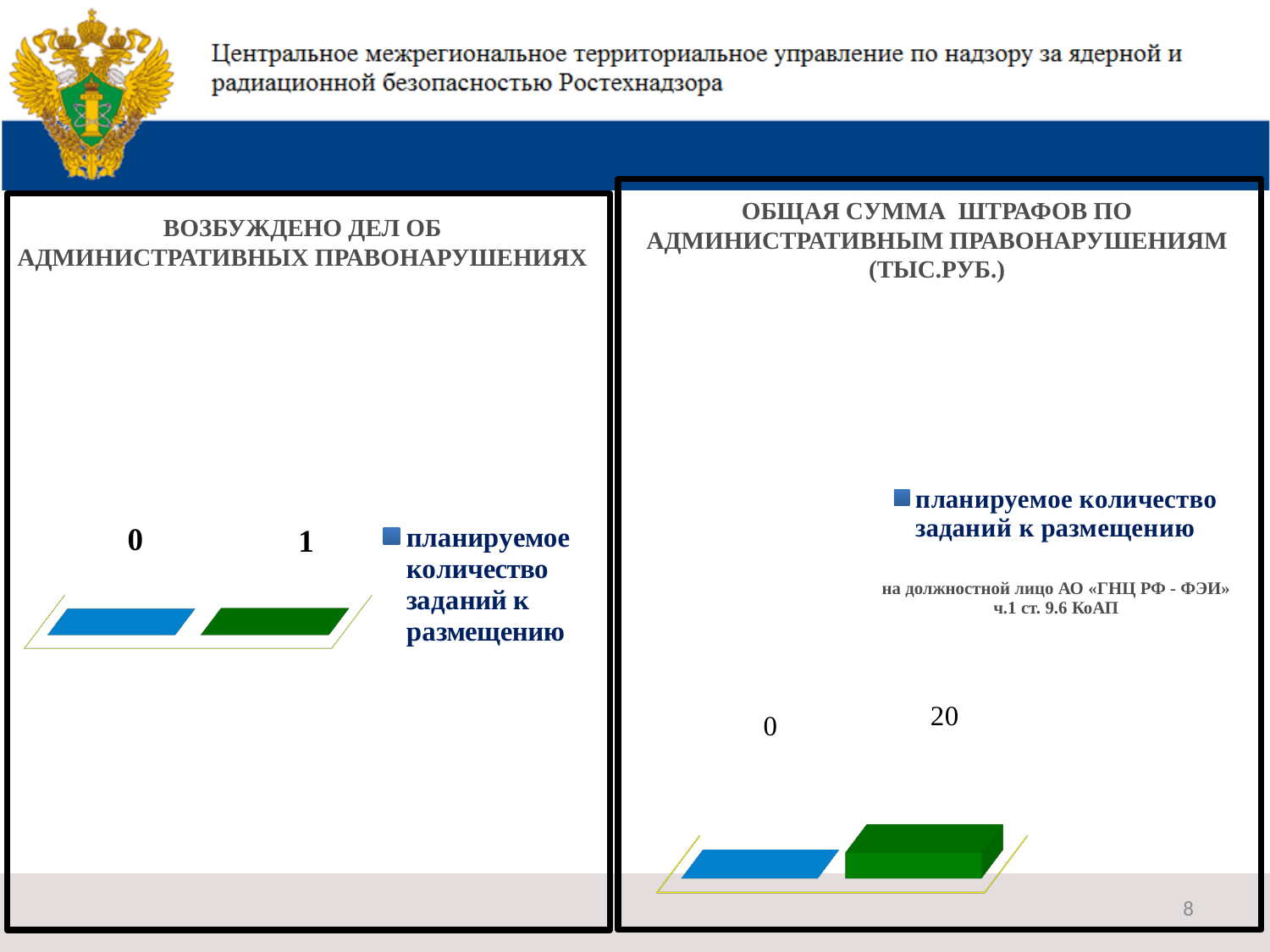
In the right chart titled «ОБЩАЯ СУММА ШТРАФОВ ПО АДМИНИСТРАТИВНЫМ ПРАВОНАРУШЕНИЯМ (ТЫС.РУБ.)», what is the difference between the two labelled values? 20 In the right chart titled «ОБЩАЯ СУММА ШТРАФОВ ПО АДМИНИСТРАТИВНЫМ ПРАВОНАРУШЕНИЯМ (ТЫС.РУБ.)», how many series does the legend list? 1 In the right chart titled «ОБЩАЯ СУММА ШТРАФОВ ПО АДМИНИСТРАТИВНЫМ ПРАВОНАРУШЕНИЯМ (ТЫС.РУБ.)», what value is labelled above the green bar? 20 What legend entry is shown for the left chart titled «ВОЗБУЖДЕНО ДЕЛ ОБ АДМИНИСТРАТИВНЫХ ПРАВОНАРУШЕНИЯХ»? планируемое количество заданий к размещению In the left chart titled «ВОЗБУЖДЕНО ДЕЛ ОБ АДМИНИСТРАТИВНЫХ ПРАВОНАРУШЕНИЯХ», what is the lowest data label shown? 0 In the left chart titled «ВОЗБУЖДЕНО ДЕЛ ОБ АДМИНИСТРАТИВНЫХ ПРАВОНАРУШЕНИЯХ», what value is labelled above the green bar? 1 In the right chart titled «ОБЩАЯ СУММА ШТРАФОВ ПО АДМИНИСТРАТИВНЫМ ПРАВОНАРУШЕНИЯМ (ТЫС.РУБ.)», what value is labelled above the blue bar? 0 What unit is given in the title of the right chart? ТЫС.РУБ. What kind of chart is the left chart titled «ВОЗБУЖДЕНО ДЕЛ ОБ АДМИНИСТРАТИВНЫХ ПРАВОНАРУШЕНИЯХ»? bar chart In the right chart titled «ОБЩАЯ СУММА ШТРАФОВ ПО АДМИНИСТРАТИВНЫМ ПРАВОНАРУШЕНИЯМ (ТЫС.РУБ.)», which bar is taller, the blue one or the green one? the green one In the left chart titled «ВОЗБУЖДЕНО ДЕЛ ОБ АДМИНИСТРАТИВНЫХ ПРАВОНАРУШЕНИЯХ», what is the highest data label shown? 1 In the left chart titled «ВОЗБУЖДЕНО ДЕЛ ОБ АДМИНИСТРАТИВНЫХ ПРАВОНАРУШЕНИЯХ», how many bars are plotted? 2